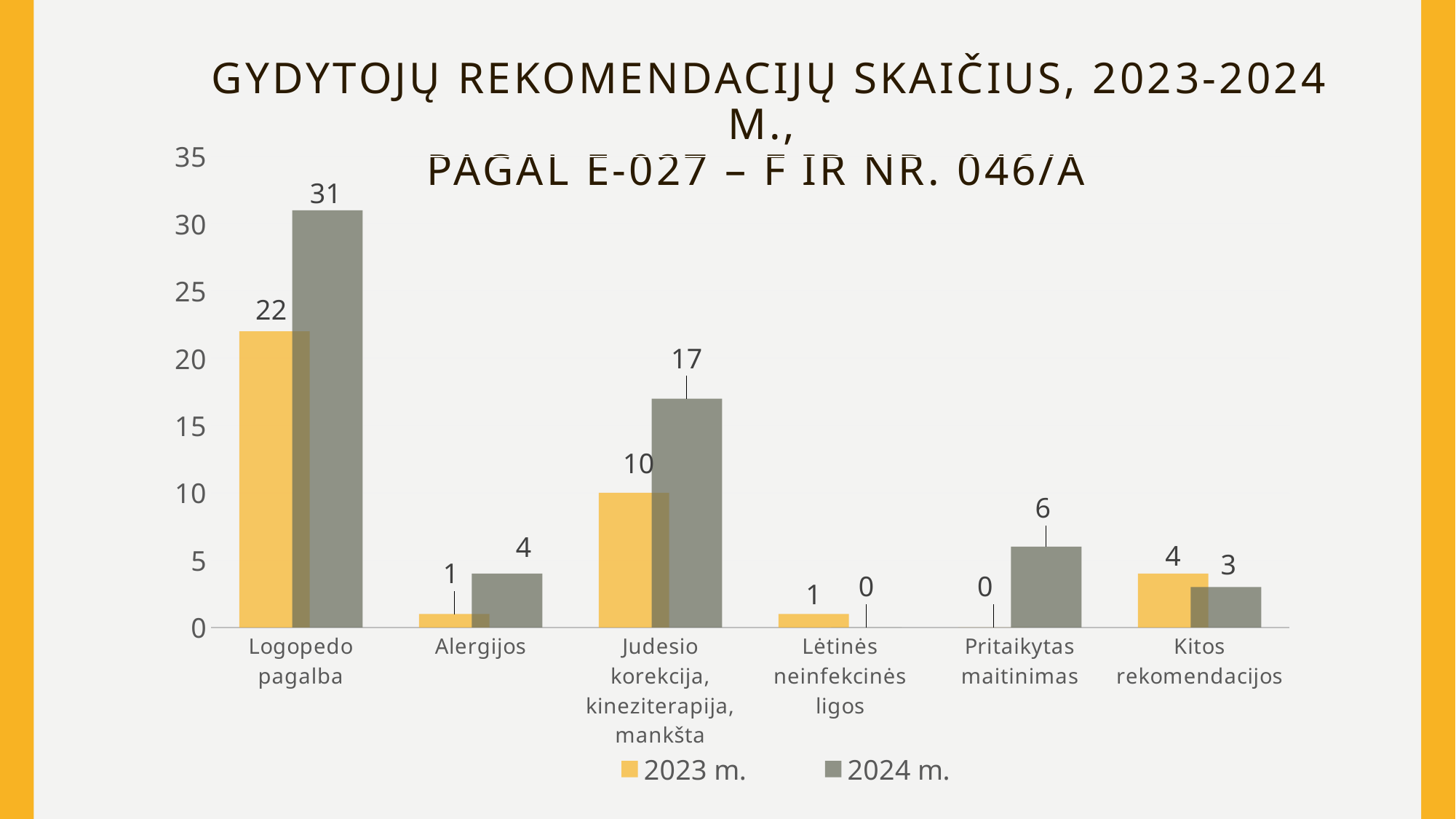
What is the value for Judesio korekcija, kineziterapija, mankšta in the 2023 m. series? 10 What kind of chart is shown on the slide? bar chart What is the value for Pritaikytas maitinimas in the 2024 m. series? 6 Is the 2024 m. value for Judesio korekcija, kineziterapija, mankšta greater or less than 15? greater How many categories are shown on the x axis? 6 Which category has the lowest value in the 2024 m. series? Lėtinės neinfekcinės ligos Which category has the highest value in the 2023 m. series? Logopedo pagalba Which is larger for Kitos rekomendacijos: the 2023 m. value or the 2024 m. value? 2023 m. How many series does the legend list? 2 Which colour represents the 2023 m. series in the legend? yellow What is the difference between the 2024 m. and 2023 m. values for Logopedo pagalba? 9 What is the value for Logopedo pagalba in the 2024 m. series? 31